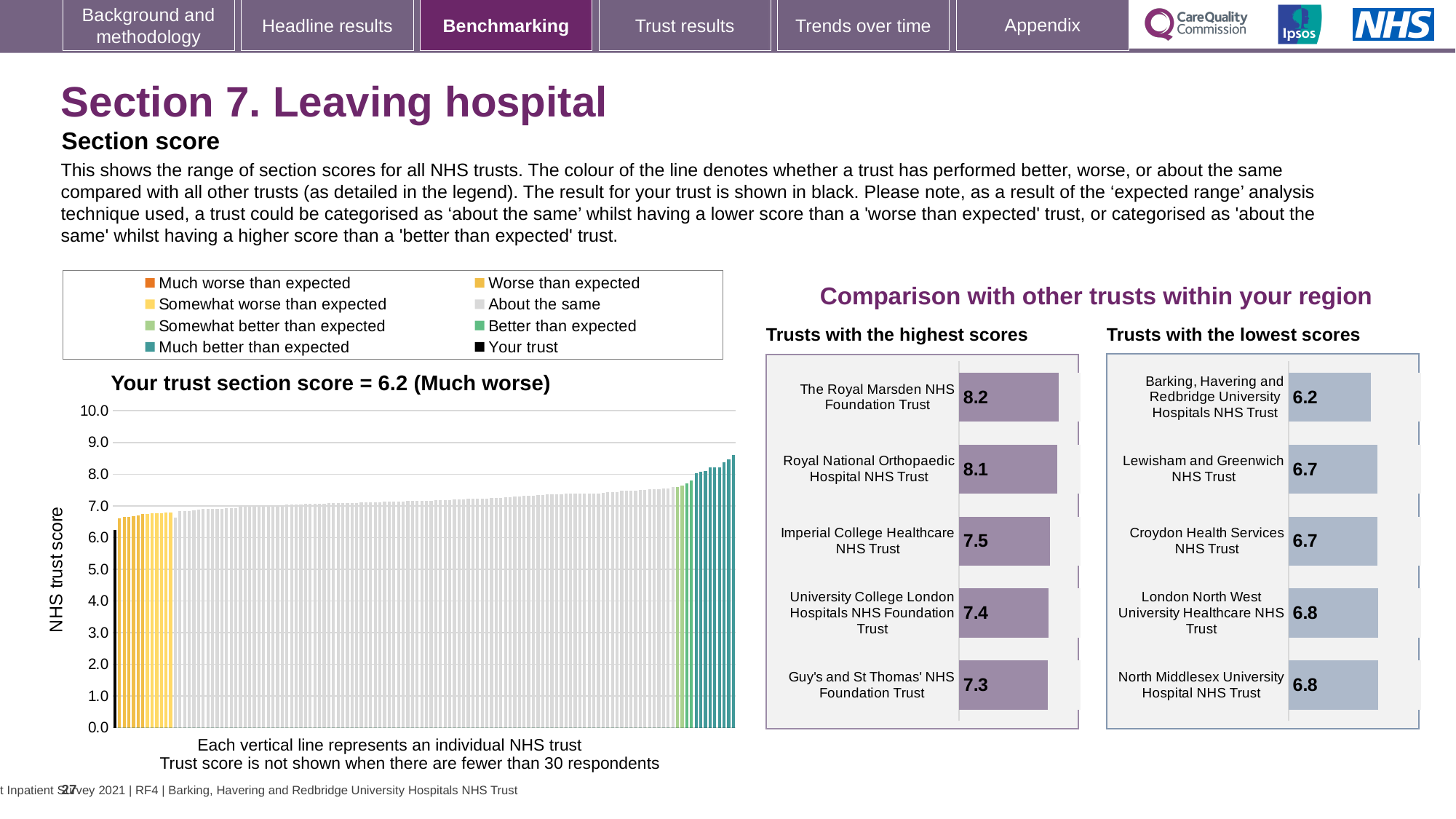
In the left-hand 'Your trust section score' chart, is the value of the tallest bar greater or less than 8.0? greater In the 'Trusts with the lowest scores' chart, how much higher is North Middlesex University Hospital NHS Trust's score than Barking, Havering and Redbridge University Hospitals NHS Trust's score? 0.6 In the 'Trusts with the lowest scores' chart, which trust has the lowest score? Barking, Havering and Redbridge University Hospitals NHS Trust In the 'Trusts with the highest scores' chart, what is the score for The Royal Marsden NHS Foundation Trust? 8.2 In the 'Trusts with the highest scores' chart, what is the score for Imperial College Healthcare NHS Trust? 7.5 In the 'Trusts with the highest scores' chart, which has the larger score: Royal National Orthopaedic Hospital NHS Trust or University College London Hospitals NHS Foundation Trust? Royal National Orthopaedic Hospital NHS Trust In the 'Trusts with the highest scores' chart, what is the difference between the scores of The Royal Marsden NHS Foundation Trust and Guy's and St Thomas' NHS Foundation Trust? 0.9 How many trusts are shown in the 'Trusts with the highest scores' chart? 5 According to the title of the left-hand chart, what is your trust's section score? 6.2 In the 'Trusts with the lowest scores' chart, what is the score for Croydon Health Services NHS Trust? 6.7 In the 'Trusts with the highest scores' chart, which trust has the highest score? The Royal Marsden NHS Foundation Trust What kind of chart is the 'Your trust section score' chart on the left of the slide? bar chart